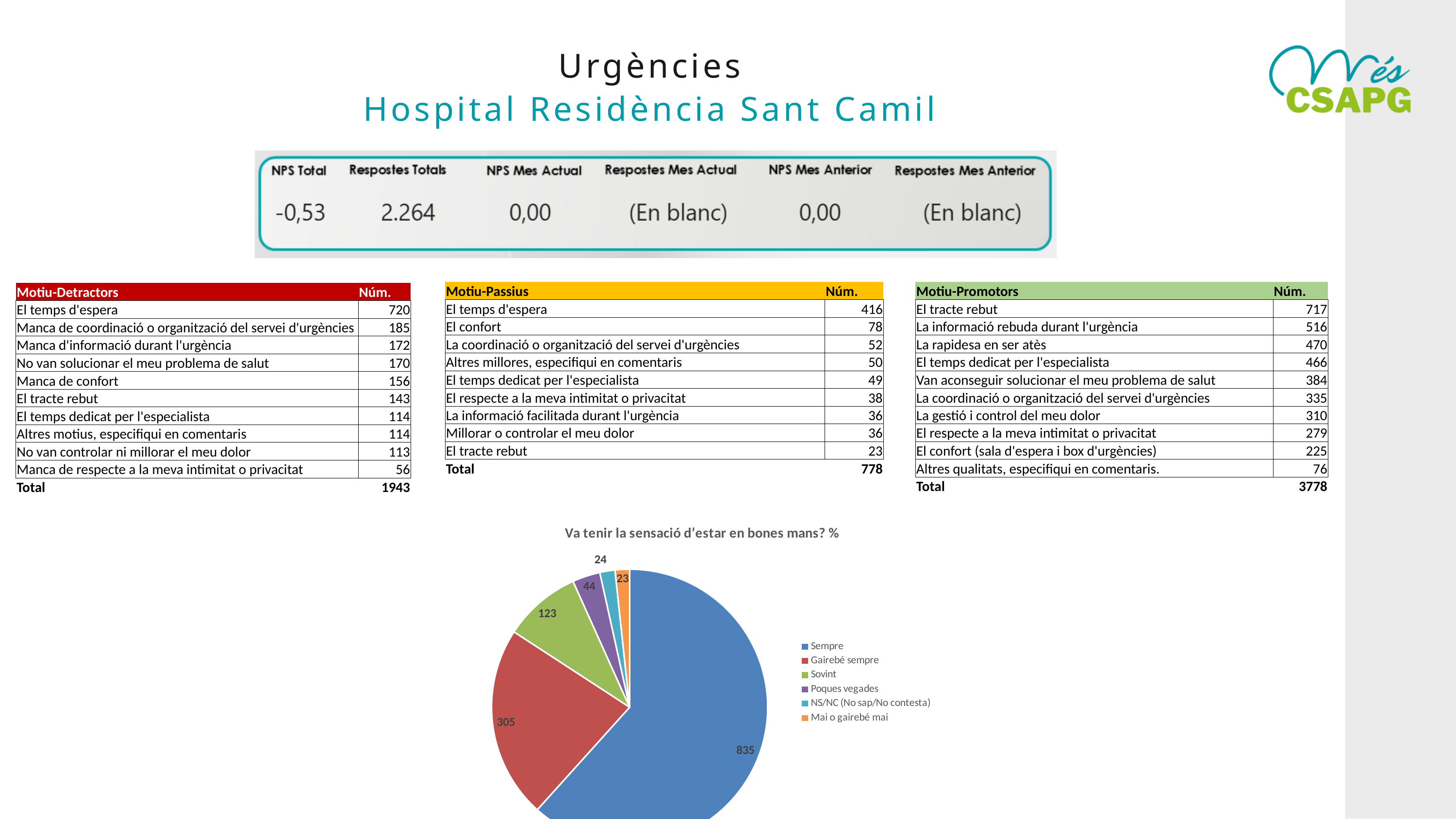
What is the value for Gairebé sempre in the pie chart? 305 What colour is the Sempre slice in the pie chart? blue What is the difference between the values for Sempre and Gairebé sempre? 530 How many entries does the pie chart legend list? 6 What is the value for Sempre in the pie chart? 835 Which is larger in the pie chart, Sovint or Poques vegades? Sovint What is the value for Sovint in the pie chart? 123 Which category has the largest slice in the pie chart? Sempre What kind of chart is shown on the slide? pie chart What is the title of the pie chart? Va tenir la sensació d'estar en bones mans? % What is the value for Poques vegades in the pie chart? 44 How many slices does the pie chart have? 6